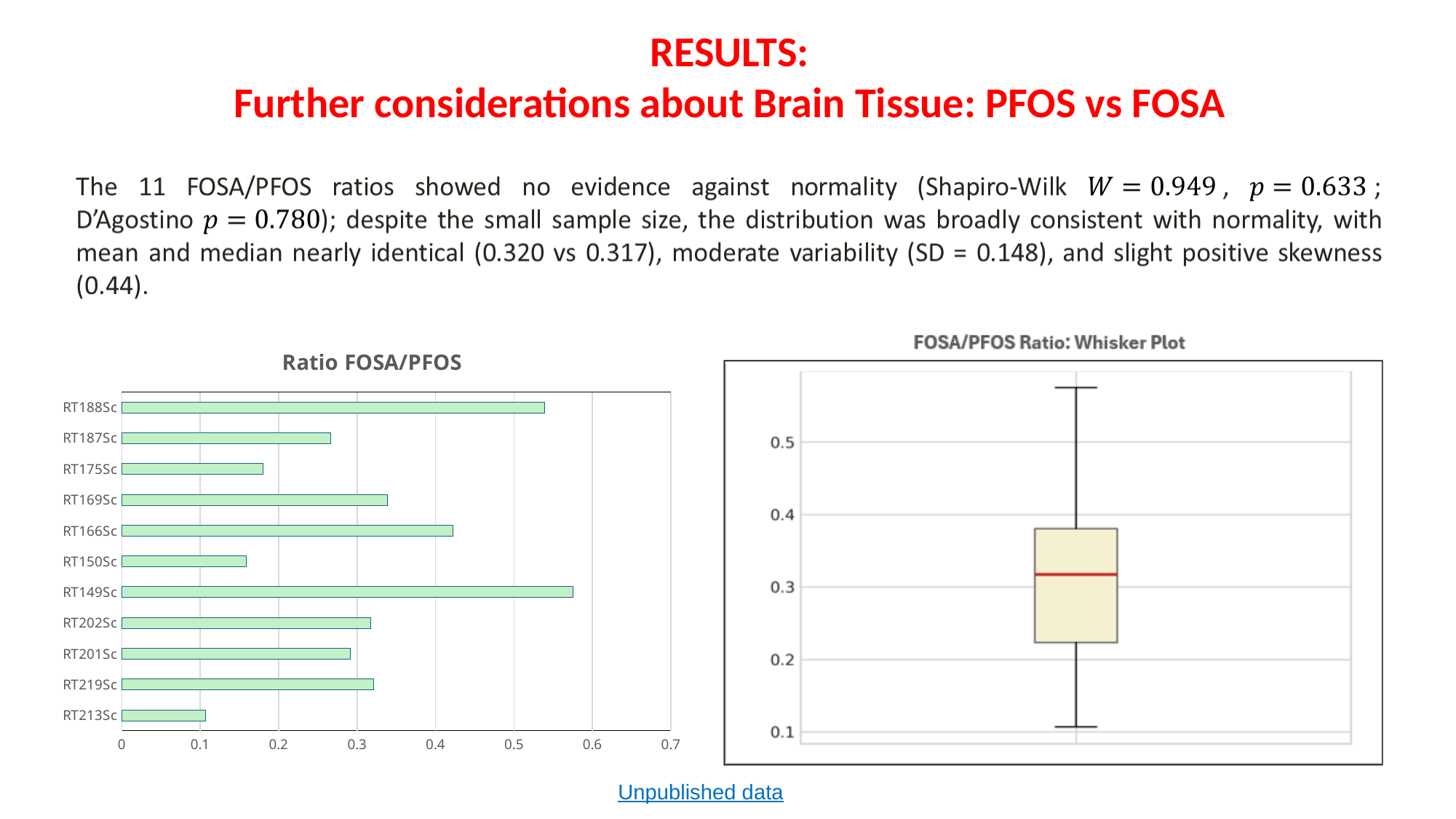
In the 'Ratio FOSA/PFOS' chart, is the value for RT175Sc greater or less than 0.2? less What is the title of the chart on the right side of the slide? FOSA/PFOS Ratio: Whisker Plot In the 'Ratio FOSA/PFOS' chart, which sample has the highest ratio? RT149Sc In the 'Ratio FOSA/PFOS' chart, which has the larger ratio, RT187Sc or RT175Sc? RT187Sc In the 'Ratio FOSA/PFOS' chart, is the value for RT213Sc greater or less than 0.2? less In the 'FOSA/PFOS Ratio: Whisker Plot' chart, what colour is the median line inside the box? Red In the 'Ratio FOSA/PFOS' chart, is the value for RT188Sc greater or less than 0.5? greater What kind of chart is the 'Ratio FOSA/PFOS' chart on the left? Bar chart In the 'Ratio FOSA/PFOS' chart, which sample has the lowest ratio? RT213Sc In the 'Ratio FOSA/PFOS' chart, which has the larger ratio, RT166Sc or RT169Sc? RT166Sc In the 'Ratio FOSA/PFOS' chart, how many samples (categories) are plotted? 11